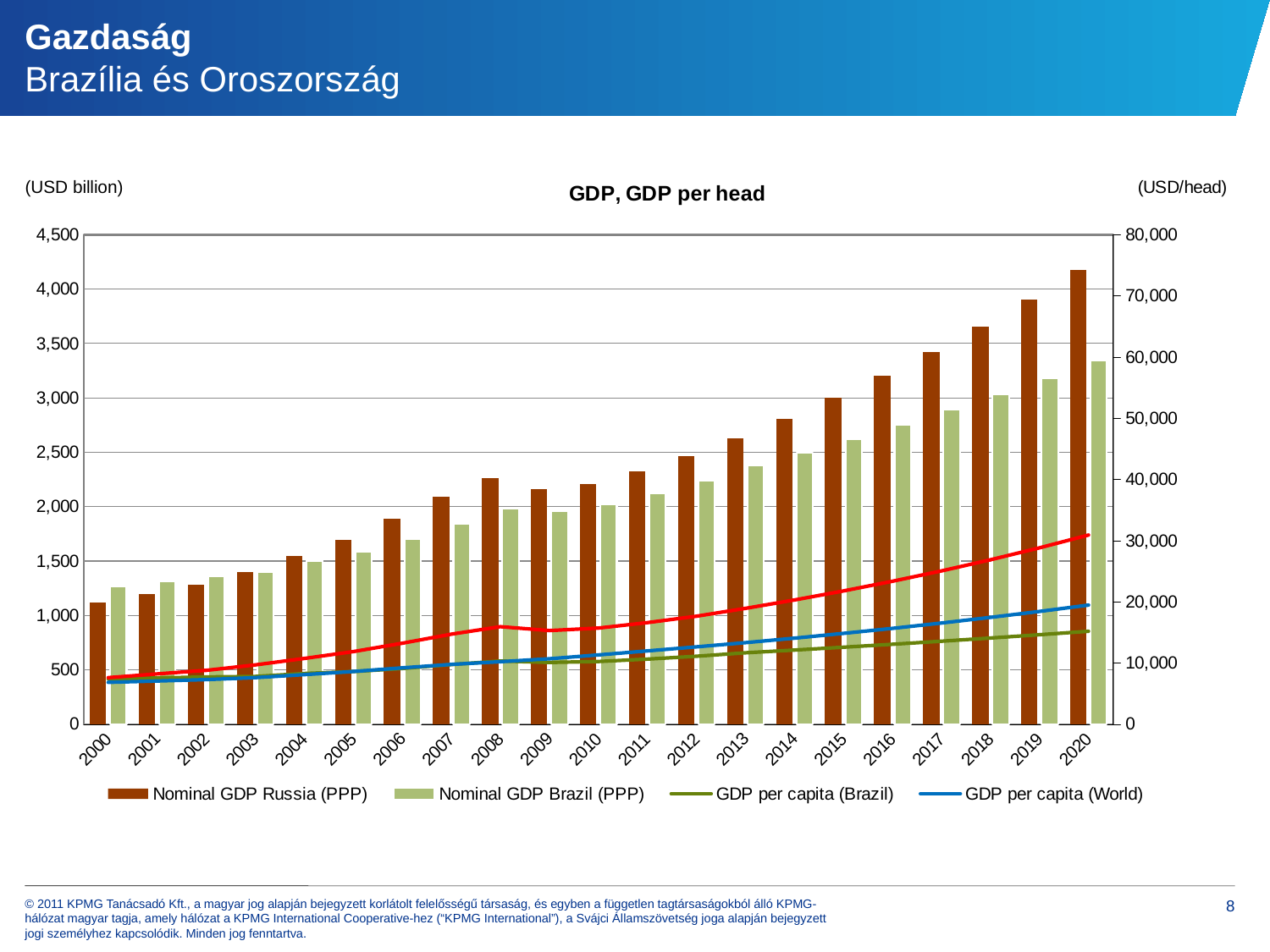
In 2020, which bar is taller: Nominal GDP Russia (PPP) or Nominal GDP Brazil (PPP)? Nominal GDP Russia (PPP) In 2000, which bar is taller: Nominal GDP Russia (PPP) or Nominal GDP Brazil (PPP)? Nominal GDP Brazil (PPP) In which year is the Nominal GDP Russia (PPP) bar highest? 2020 What kind of chart is shown on the slide? A combination bar and line chart What is the title of the chart? GDP, GDP per head How many series does the legend list? 4 Does the GDP per capita (World) line rise or fall from 2000 to 2020? Rise How many years are shown on the x axis? 21 In which year is the Nominal GDP Brazil (PPP) bar lowest? 2000 Is the value for Nominal GDP Russia (PPP) in 2020 greater or less than 4,000? greater Is the value for Nominal GDP Brazil (PPP) in 2020 greater or less than 3,000? greater Is the value for Nominal GDP Russia (PPP) in 2005 greater or less than 1,500? greater